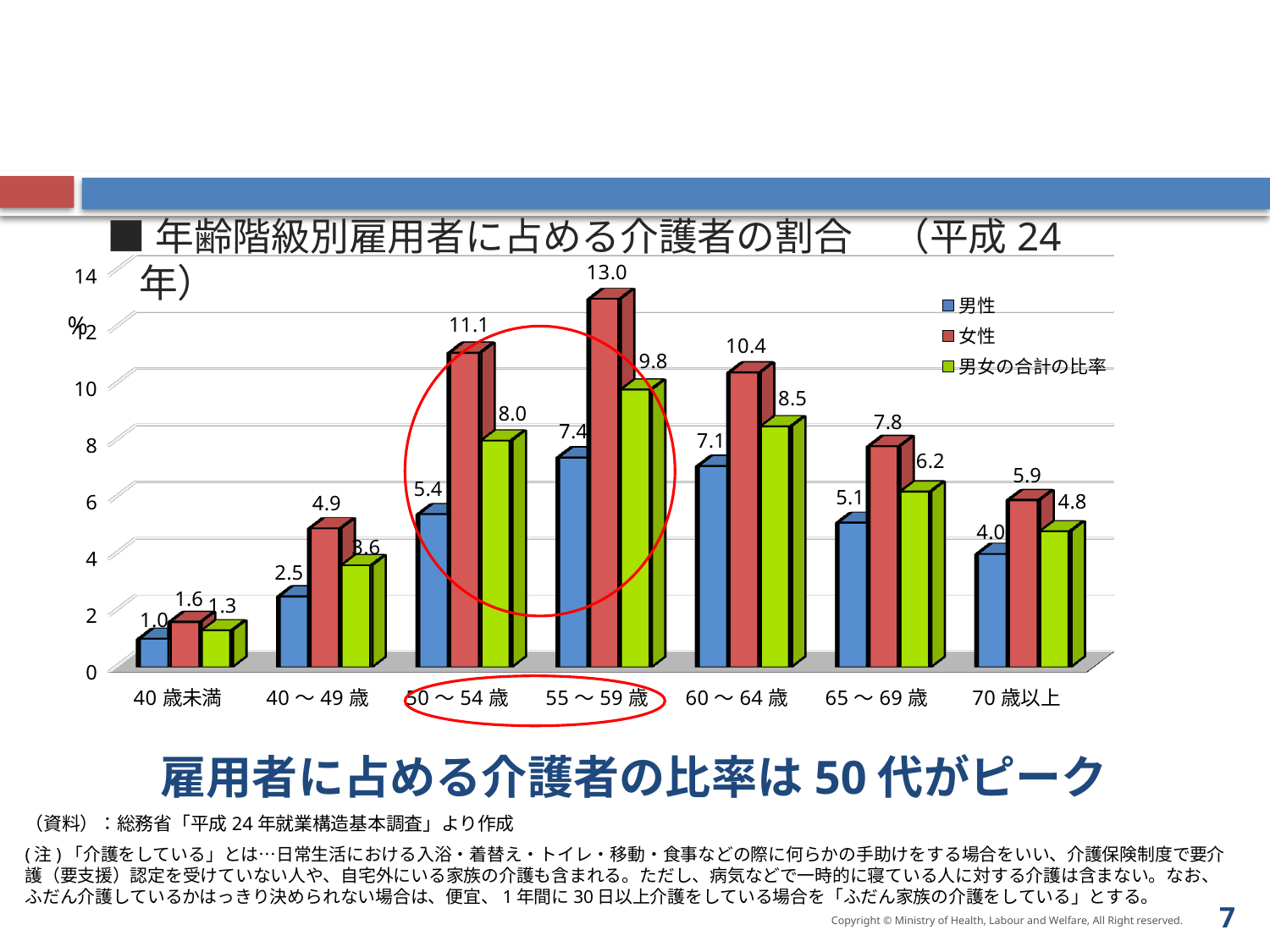
Which age group has the highest value for 女性? 55～59歳 Which is larger, the 男性 value for 55～59歳 or the 男性 value for 60～64歳? 55～59歳 How many series does the legend list? 3 What is the value for 男性 in the 50～54歳 age group? 5.4 What kind of chart is shown on the slide? Bar chart Which age group has the lowest value for 男性? 40歳未満 Which series is shown in green in the legend? 男女の合計の比率 Do the 女性 values rise or fall from 55～59歳 to 70歳以上? Fall What is the value for 女性 in the 55～59歳 age group? 13.0 What is the value for 男女の合計の比率 in the 60～64歳 age group? 8.5 How many age groups are shown on the x axis? 7 What is the difference between the 女性 and 男性 values in the 50～54歳 age group? 5.7